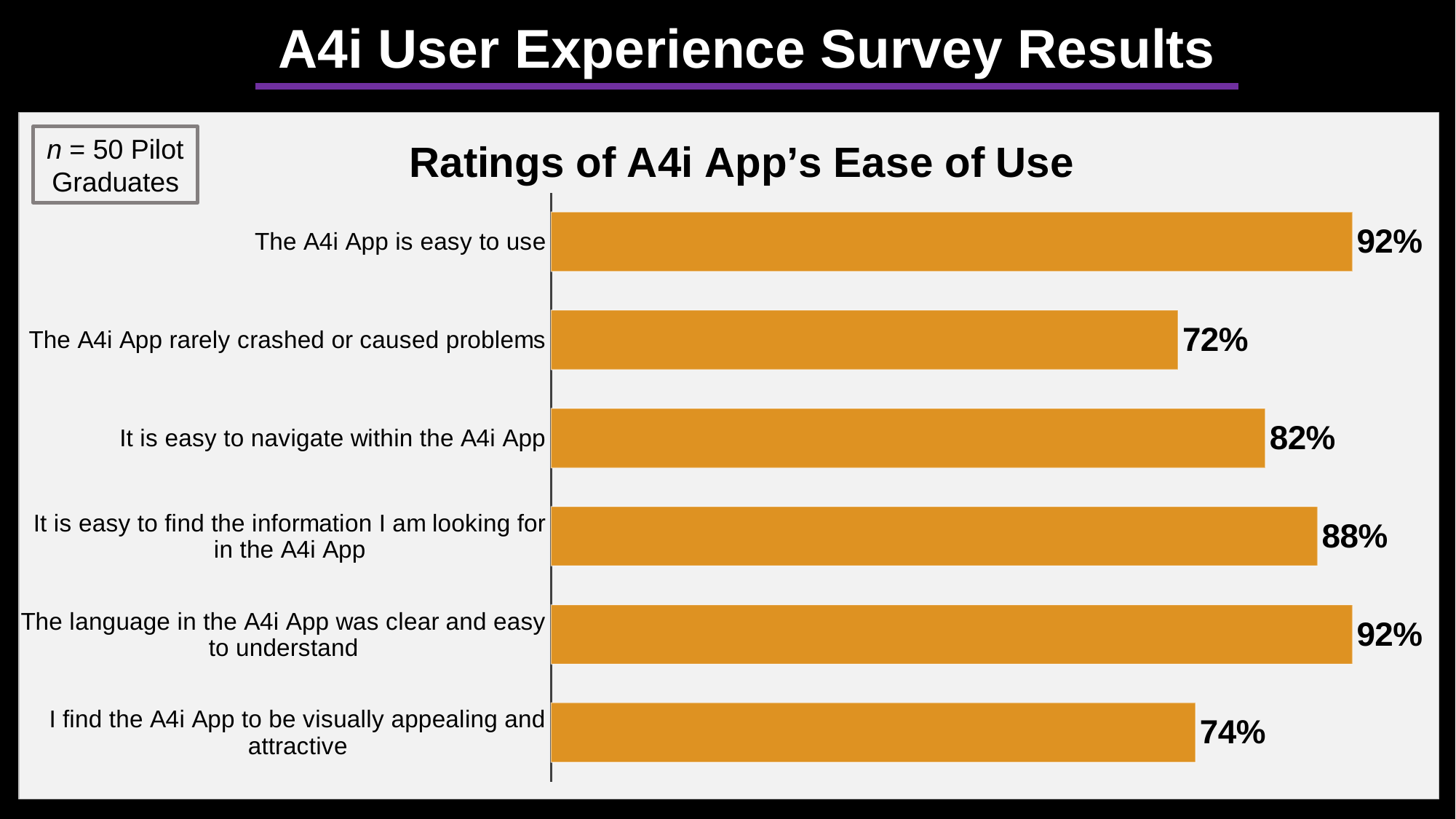
What is the value for "The A4i App rarely crashed or caused problems"? 72% What is the value for "I find the A4i App to be visually appealing and attractive"? 74% What is the title of the chart? Ratings of A4i App's Ease of Use What is the difference between the rating for "It is easy to find the information I am looking for in the A4i App" and "It is easy to navigate within the A4i App"? 6% What is the difference between the highest rating (92%) and the lowest rating (72%) in the chart? 20% Which is larger: the rating for "I find the A4i App to be visually appealing and attractive" or for "The A4i App rarely crashed or caused problems"? I find the A4i App to be visually appealing and attractive How many pilot graduates responded to the survey, according to the slide? 50 What is the value for "It is easy to navigate within the A4i App"? 82% Which statement has the lowest rating in the chart? The A4i App rarely crashed or caused problems How many statements are rated in the chart? 6 What kind of chart is shown on the slide? Bar chart What percentage of respondents rated "The A4i App is easy to use"? 92%